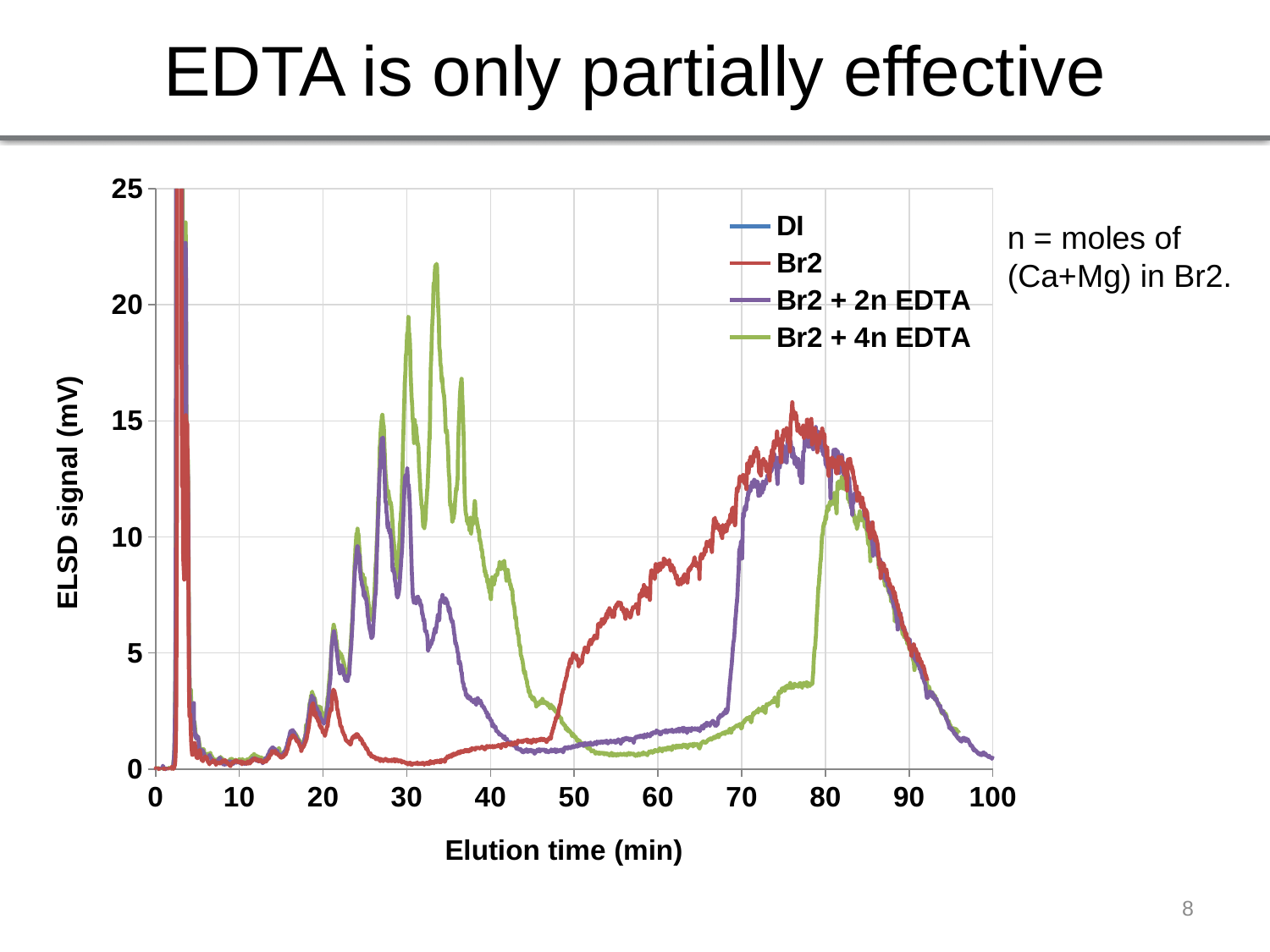
What kind of chart is shown on the slide? line chart At 60 min, which series has the larger value: Br2 or Br2 + 4n EDTA? Br2 What is the label of the y axis? ELSD signal (mV) How many series does the legend list? 4 Is the peak value of the Br2 + 4n EDTA series between 30 and 40 min greater or less than 20? greater What is the label of the x axis? Elution time (min) Is the value of the Br2 series at 60 min greater or less than 5? greater Does the Br2 series rise or fall between 50 and 75 min? rise Is the value of the Br2 series at 30 min greater or less than 5? less Which series reaches the highest peak between 20 and 45 min? Br2 + 4n EDTA